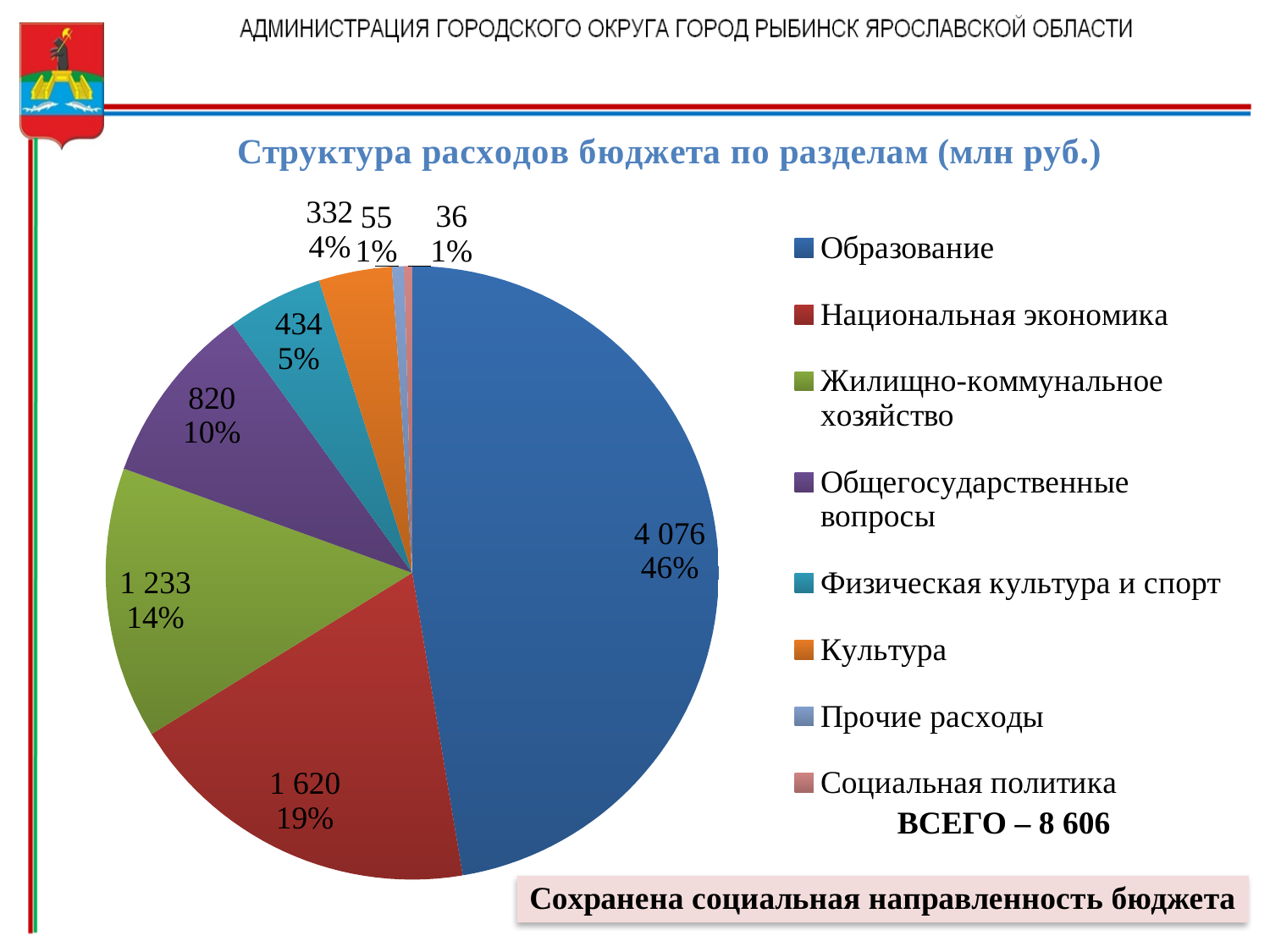
What share of the pie does Общегосударственные вопросы take? 10% Which is larger, the value for Культура or the value for Физическая культура и спорт? Физическая культура и спорт What is the value for Образование in the pie chart? 4 076 What is the value for Национальная экономика? 1 620 What share of the pie does Национальная экономика take? 19% What is the value for Физическая культура и спорт? 434 What kind of chart is shown on the slide? Pie chart Which category has the largest slice of the pie? Образование Which category has the smallest slice of the pie? Социальная политика How many categories does the legend list? 8 What is the difference between the values for Национальная экономика and Жилищно-коммунальное хозяйство? 387 What is the value for Жилищно-коммунальное хозяйство? 1 233